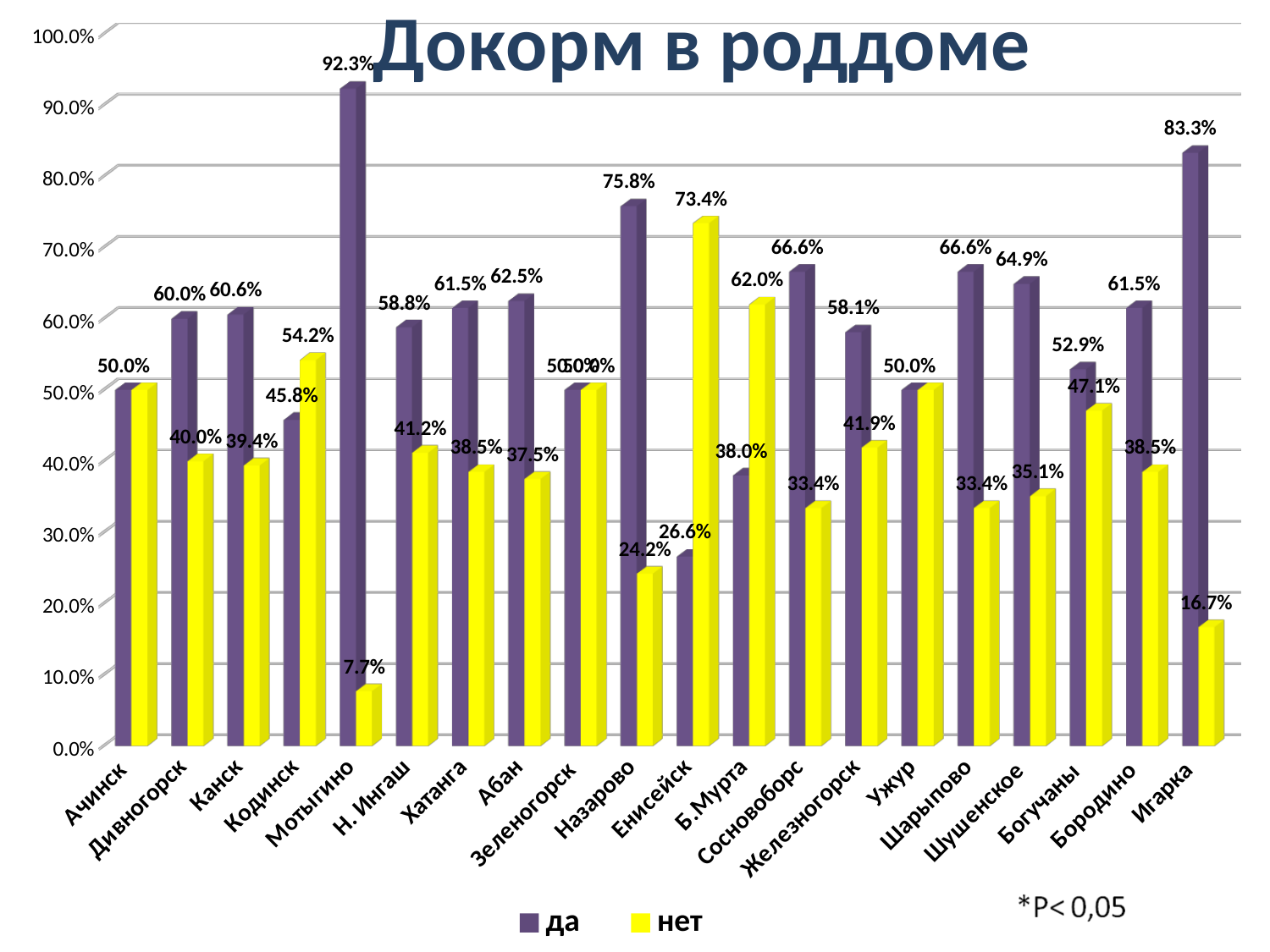
Which category has the lowest value in the "нет" series? Мотыгино How many categories are shown on the x axis? 20 What is the value of the "нет" series for Кодинск? 54.2% Which category has the lowest value in the "да" series? Енисейск Which is larger for Б.Мурта: the "да" value or the "нет" value? нет What is the value of the "нет" series for Енисейск? 73.4% How many series does the legend list? 2 Which category has the highest value in the "да" series? Мотыгино What is the difference between the "да" and "нет" values for Назарово? 51.6% What is the value of the "да" series for Мотыгино? 92.3% What is the value of the "да" series for Игарка? 83.3% What type of chart is shown on the slide? Bar chart